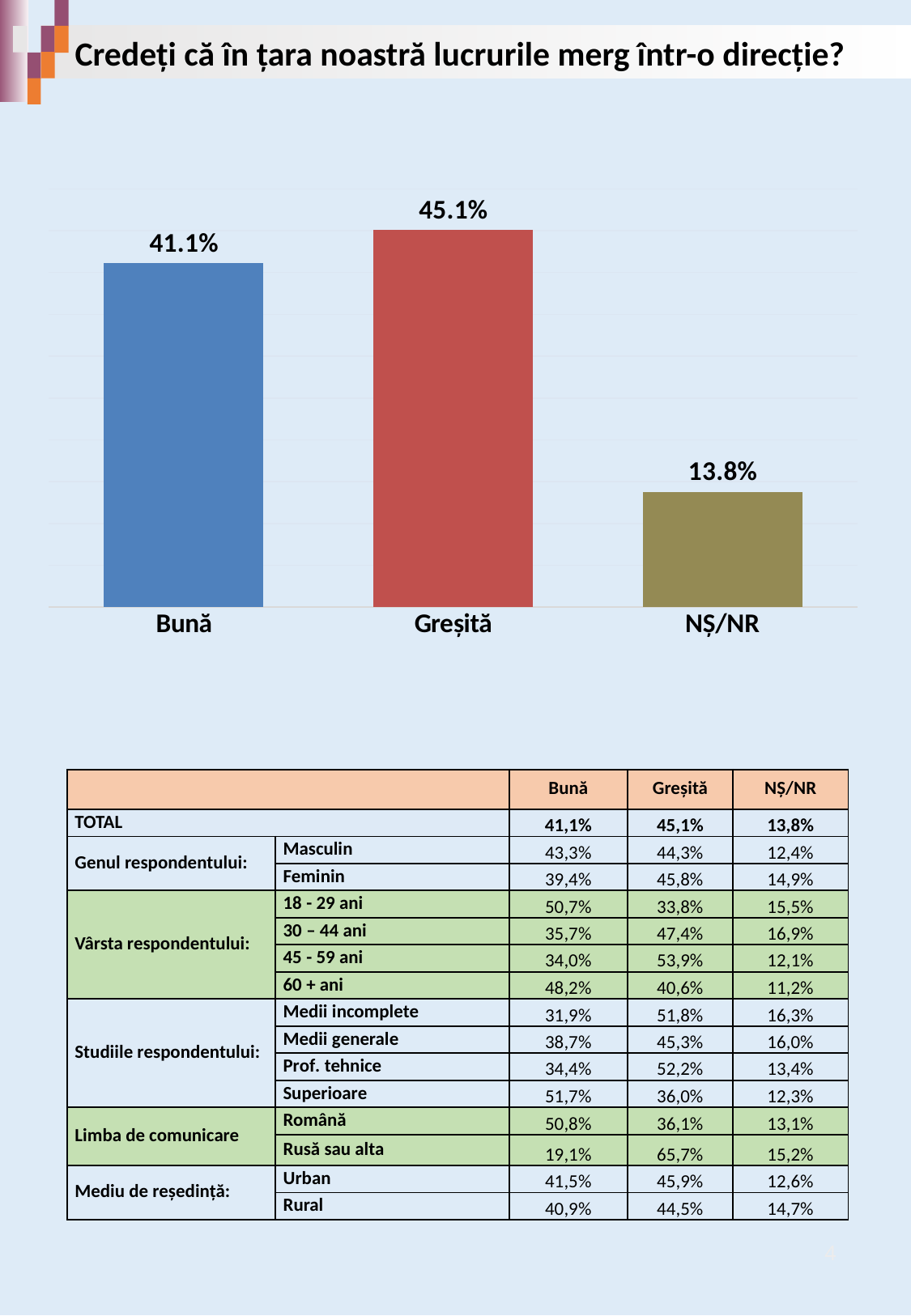
What is the difference between the values for Greșită and Bună? 4.0% How many categories are shown in the chart? 3 Which category has the highest value? Greșită What is the value for NȘ/NR? 13.8% What is the value for Bună? 41.1% What colour is the bar for Greșită? red What is the value for Greșită? 45.1% Which is larger, the value for Bună or the value for NȘ/NR? Bună Which category has the lowest value? NȘ/NR What is the difference between the values for Bună and NȘ/NR? 27.3% What is the title of the slide above the chart? Credeți că în țara noastră lucrurile merg într-o direcție? What kind of chart is shown on the slide? bar chart